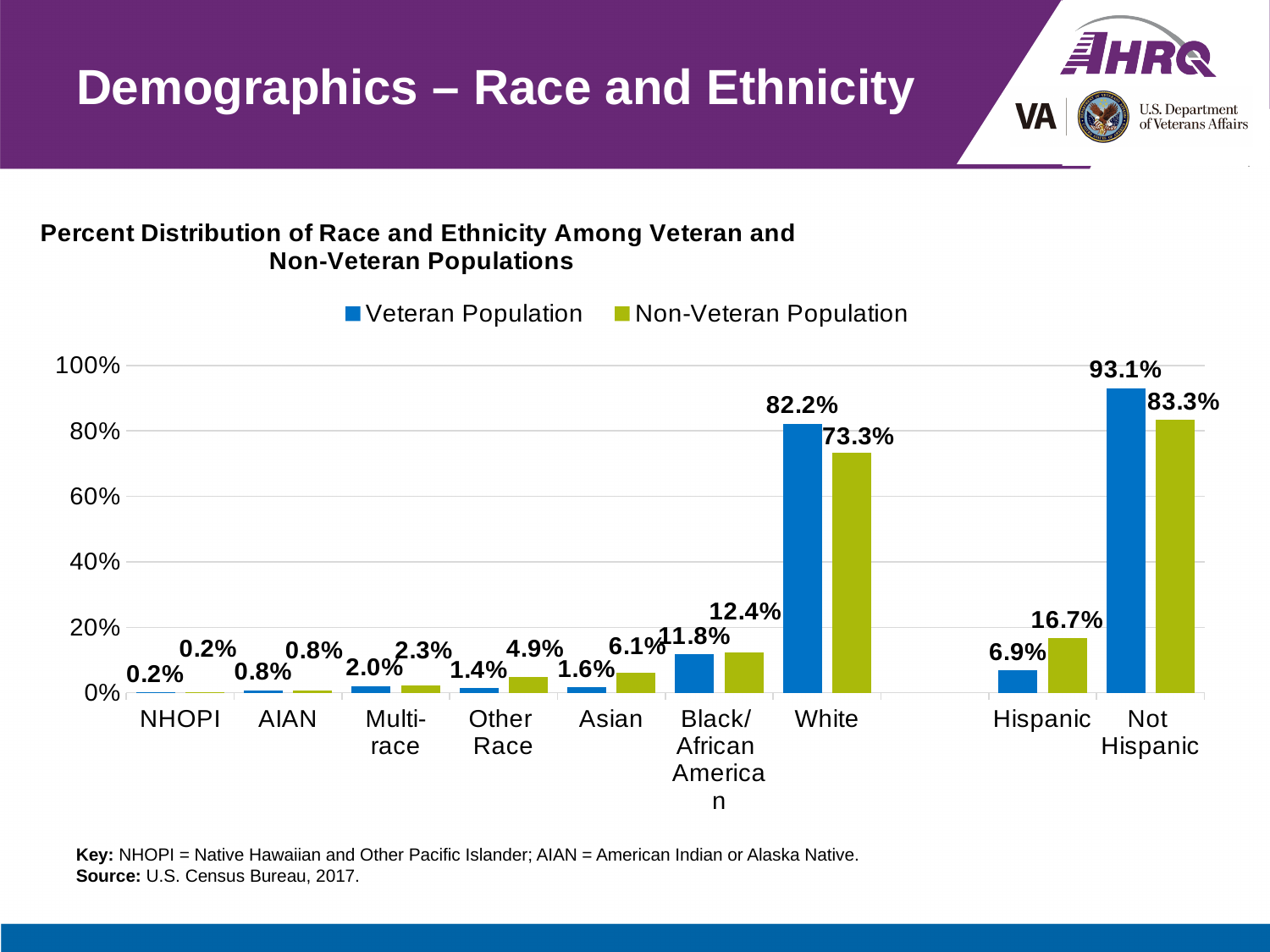
What is the Non-Veteran Population value for Hispanic? 16.7% What is the difference between the Veteran Population and Non-Veteran Population values for White? 8.9% How many categories are shown on the x axis? 9 Which category has the highest Veteran Population value? Not Hispanic How many series does the legend list? 2 What is the Veteran Population value for White? 82.2% Is the Veteran Population value for Not Hispanic greater or less than 80%? greater What is the Non-Veteran Population value for Other Race? 4.9% Which category has the lowest Non-Veteran Population value? NHOPI What kind of chart is shown on the slide? Bar chart Which is larger for Asian: the Veteran Population value or the Non-Veteran Population value? Non-Veteran Population What is the Veteran Population value for Black/African American? 11.8%